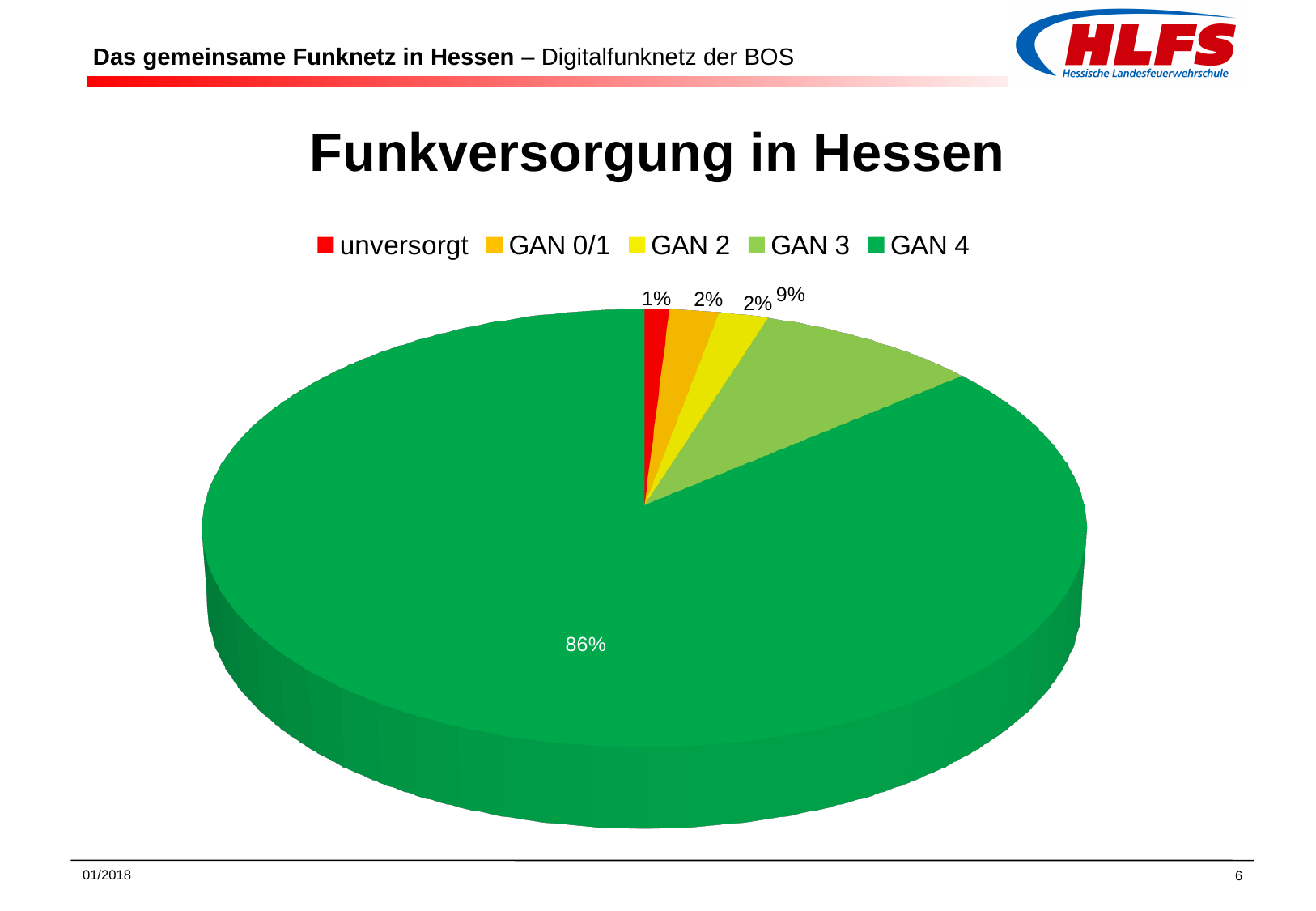
What type of chart is shown on the slide? pie chart Which category has the smallest slice of the pie? unversorgt How many slices does the pie chart have? 5 How many entries does the legend list? 5 What is the value shown for GAN 0/1? 2% What is the value shown for unversorgt? 1% Which is larger, the slice for GAN 3 or the slice for GAN 2? GAN 3 What is the title of the chart? Funkversorgung in Hessen Which category has the largest slice of the pie? GAN 4 What is the value shown for GAN 3? 9% What share of the pie does GAN 4 have? 86% What is the difference in percentage points between GAN 4 and GAN 3? 77